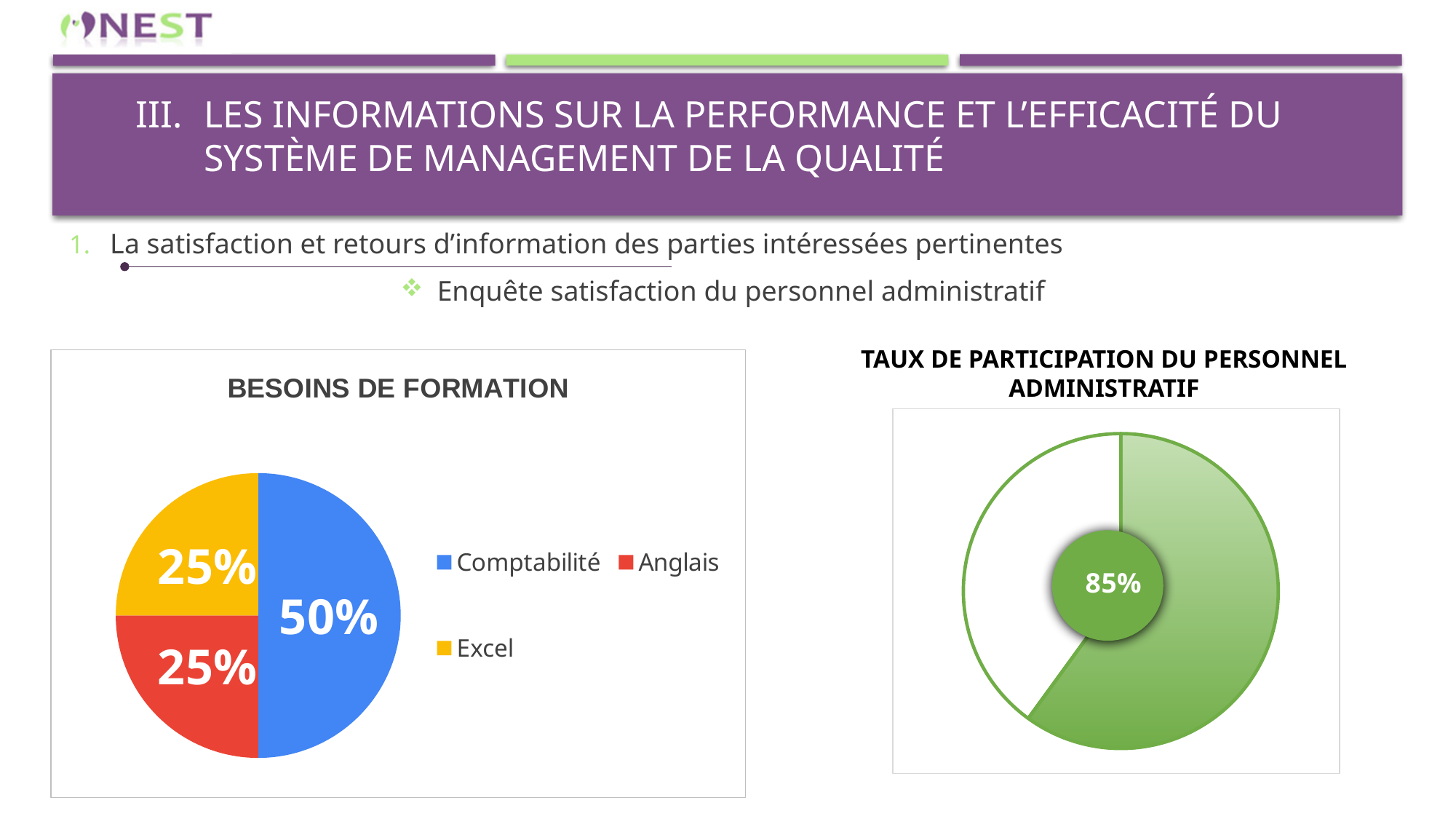
In the 'BESOINS DE FORMATION' chart, what is the value for Anglais? 25% What is the title of the chart on the left of the slide? BESOINS DE FORMATION In the 'BESOINS DE FORMATION' chart, what share of the pie does Comptabilité represent? 50% In the 'BESOINS DE FORMATION' chart, what is the difference between the Comptabilité share and the Anglais share? 25% What kind of chart is the 'BESOINS DE FORMATION' chart? Pie chart What kind of chart is the 'TAUX DE PARTICIPATION DU PERSONNEL ADMINISTRATIF' chart? Doughnut chart In the 'TAUX DE PARTICIPATION DU PERSONNEL ADMINISTRATIF' chart, what participation rate is shown? 85% In the 'BESOINS DE FORMATION' chart, which colour represents Anglais? Red In the 'BESOINS DE FORMATION' chart, how many categories does the legend list? 3 In the 'BESOINS DE FORMATION' chart, what is the value for Excel? 25% In the 'BESOINS DE FORMATION' chart, which is larger, Comptabilité or Excel? Comptabilité In the 'BESOINS DE FORMATION' chart, which category has the largest slice? Comptabilité